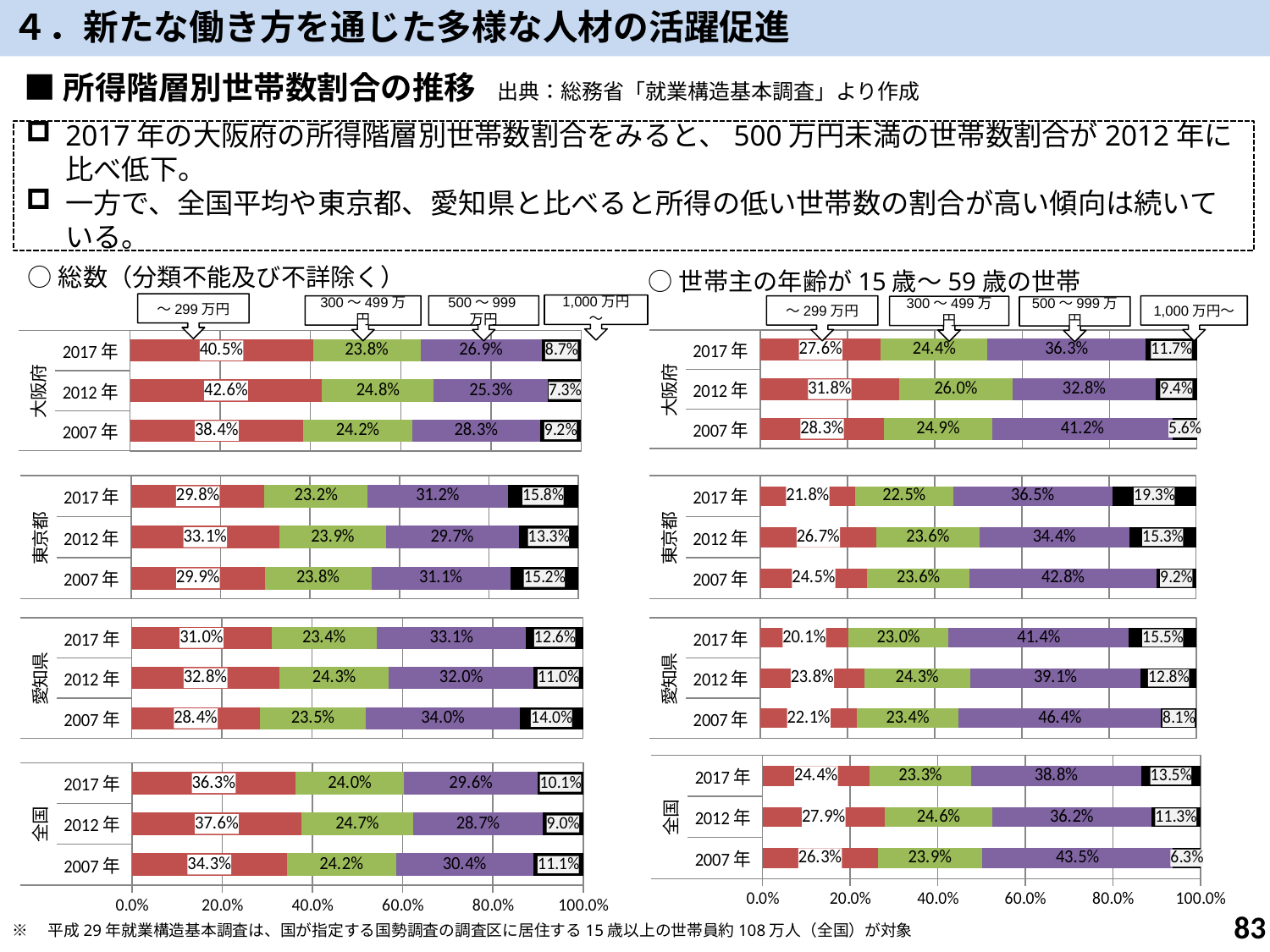
What kind of chart is the right chart (世帯主の年齢が15歳～59歳の世帯)? stacked bar chart In the right chart (世帯主の年齢が15歳～59歳の世帯), what is the share of the 300～499万円 bracket for 全国 in 2012年? 24.6% In the left chart (総数), what is the share of households with income under 299万円 in 大阪府 in 2017年? 40.5% How many income-bracket series does the legend of the left chart (総数) list? 4 In the right chart (世帯主の年齢が15歳～59歳の世帯), what is the share of the 500～999万円 bracket for 愛知県 in 2007年? 46.4% In the left chart (総数), by how many percentage points did the ～299万円 share for 大阪府 fall from 2012年 to 2017年? 2.1 percentage points In the left chart (総数), which region has the lowest ～299万円 share in 2017年? 東京都 In the right chart (世帯主の年齢が15歳～59歳の世帯), which region has the highest 1,000万円～ share in 2017年? 東京都 In the left chart (総数), what is the combined share of the ～299万円 and 300～499万円 brackets for 大阪府 in 2017年? 64.3% In the left chart (総数), is the ～299万円 share for 大阪府 in 2017年 larger or smaller than that for 全国 in 2017年? larger In the left chart (総数), what is the share of the 1,000万円～ bracket for 東京都 in 2017年? 15.8% In the right chart (世帯主の年齢が15歳～59歳の世帯), how did the 1,000万円～ share for 大阪府 change from 2007年 to 2017年? It rose (5.6% to 9.4% to 11.7%)